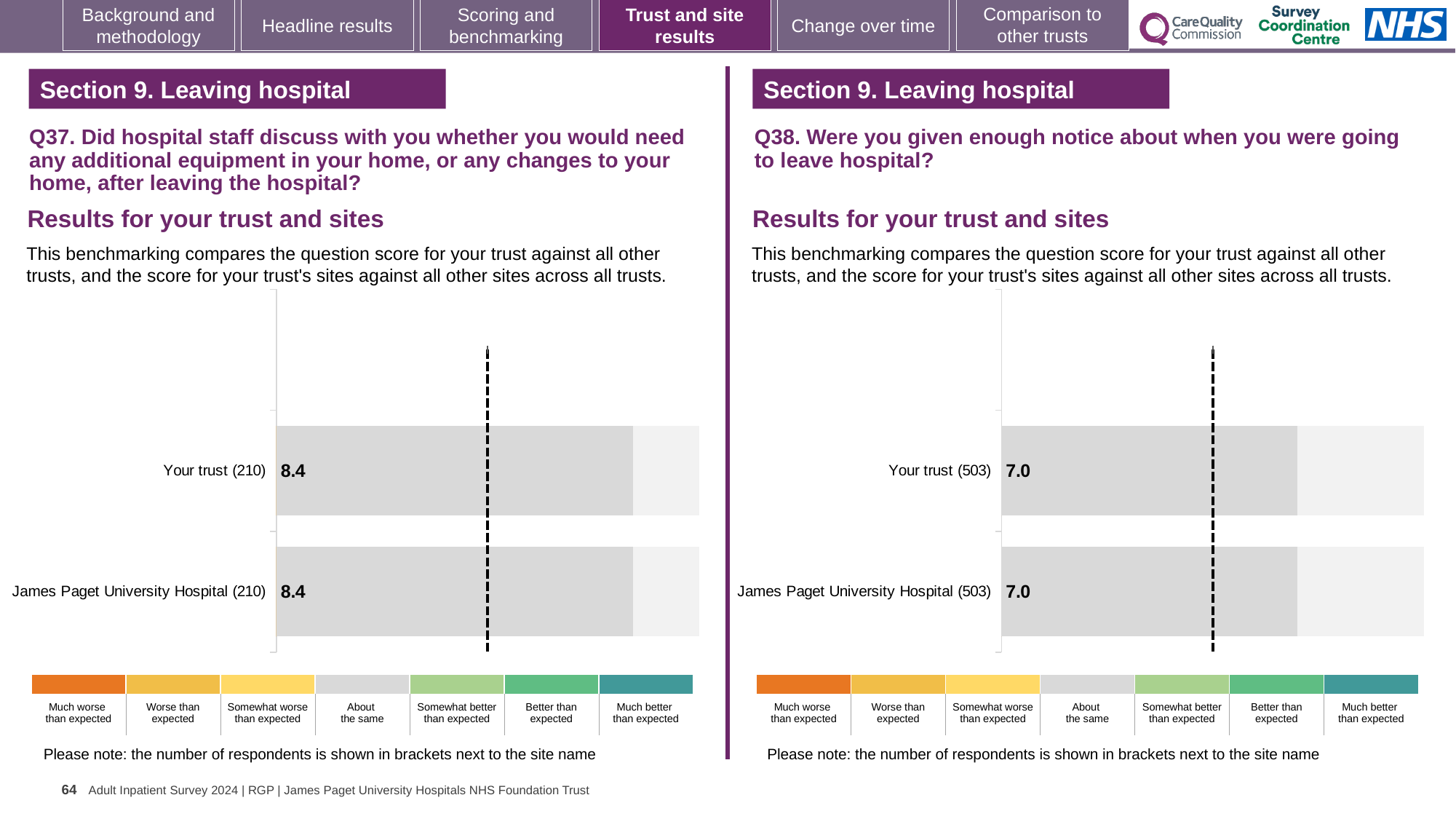
How many categories does the colour key below the Q37 chart (left) list? 7 On the Q37 chart (left), what is the difference between the score for Your trust and the score for James Paget University Hospital? 0.0 On the Q38 chart (right), what is the score for James Paget University Hospital? 7.0 On the Q38 chart (right), which category of the colour key does the grey colour of the bars correspond to? About the same On the Q37 chart (left), how many respondents are shown in brackets for Your trust? 210 What kind of chart is the Q37 chart on the left? Bar chart On the Q38 chart (right), how many respondents are shown in brackets for James Paget University Hospital? 503 On the Q38 chart (right), what is the score for Your trust? 7.0 On the Q37 chart (left), what is the score for Your trust? 8.4 On the Q38 chart (right), how many bars are plotted? 2 On the Q38 chart (right), is the score for Your trust greater or less than 8? less On the Q37 chart (left), what is the score for James Paget University Hospital? 8.4